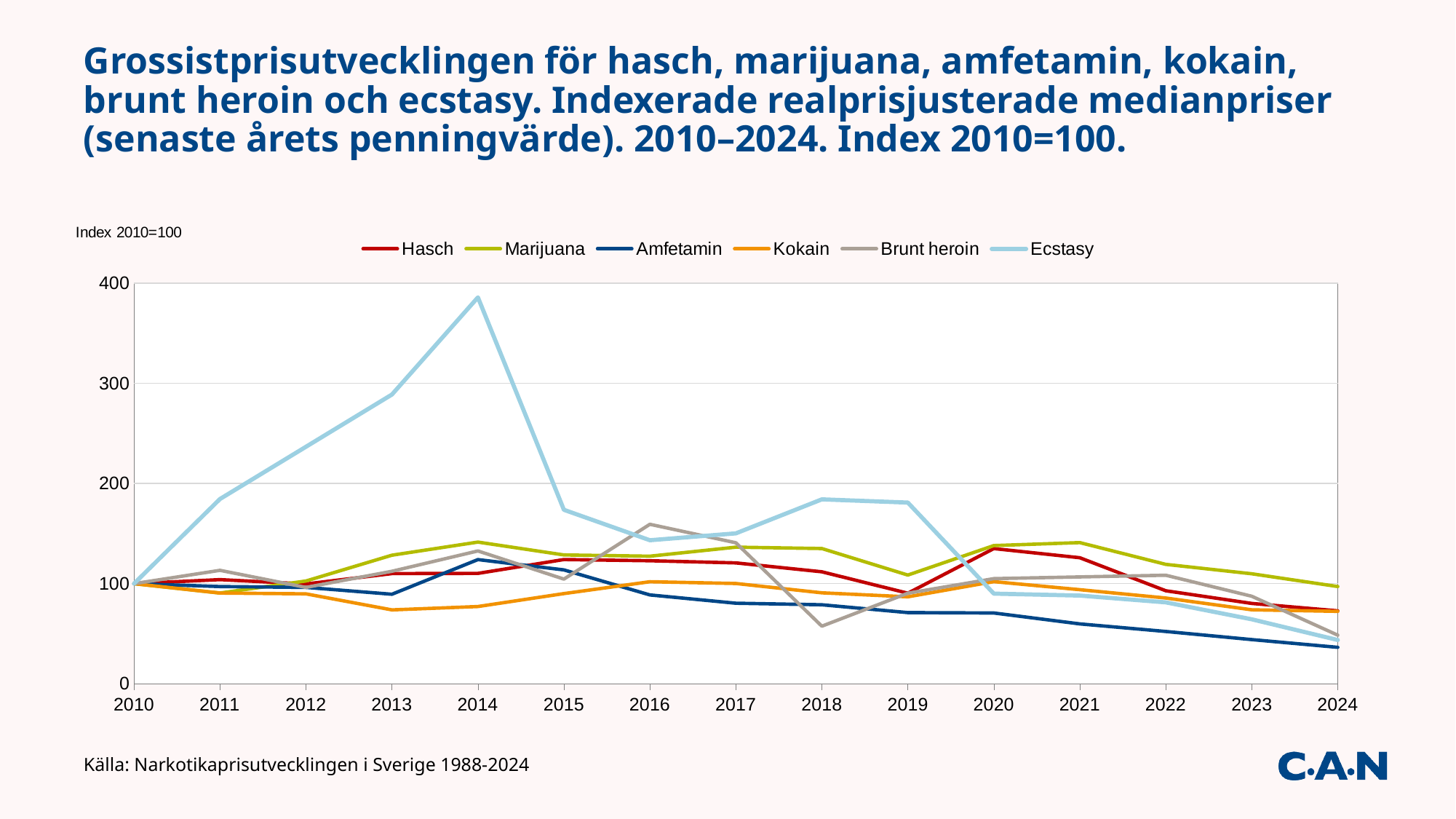
How many series does the legend list? 6 Is the value for Marijuana in 2021 greater or less than 100? greater Is the value for Brunt heroin in 2018 greater or less than 100? less Which series reaches the highest value anywhere in the chart? Ecstasy What colour is the Ecstasy line in the legend? Light blue How many years are plotted along the x axis? 15 Is the value for Amfetamin in 2024 greater or less than 50? less In 2014, which is larger: the value for Ecstasy or the value for Hasch? Ecstasy In which year does the Ecstasy series reach its peak? 2014 What kind of chart is shown on the slide? Line chart Does the Amfetamin series rise or fall from 2016 to 2024? Fall